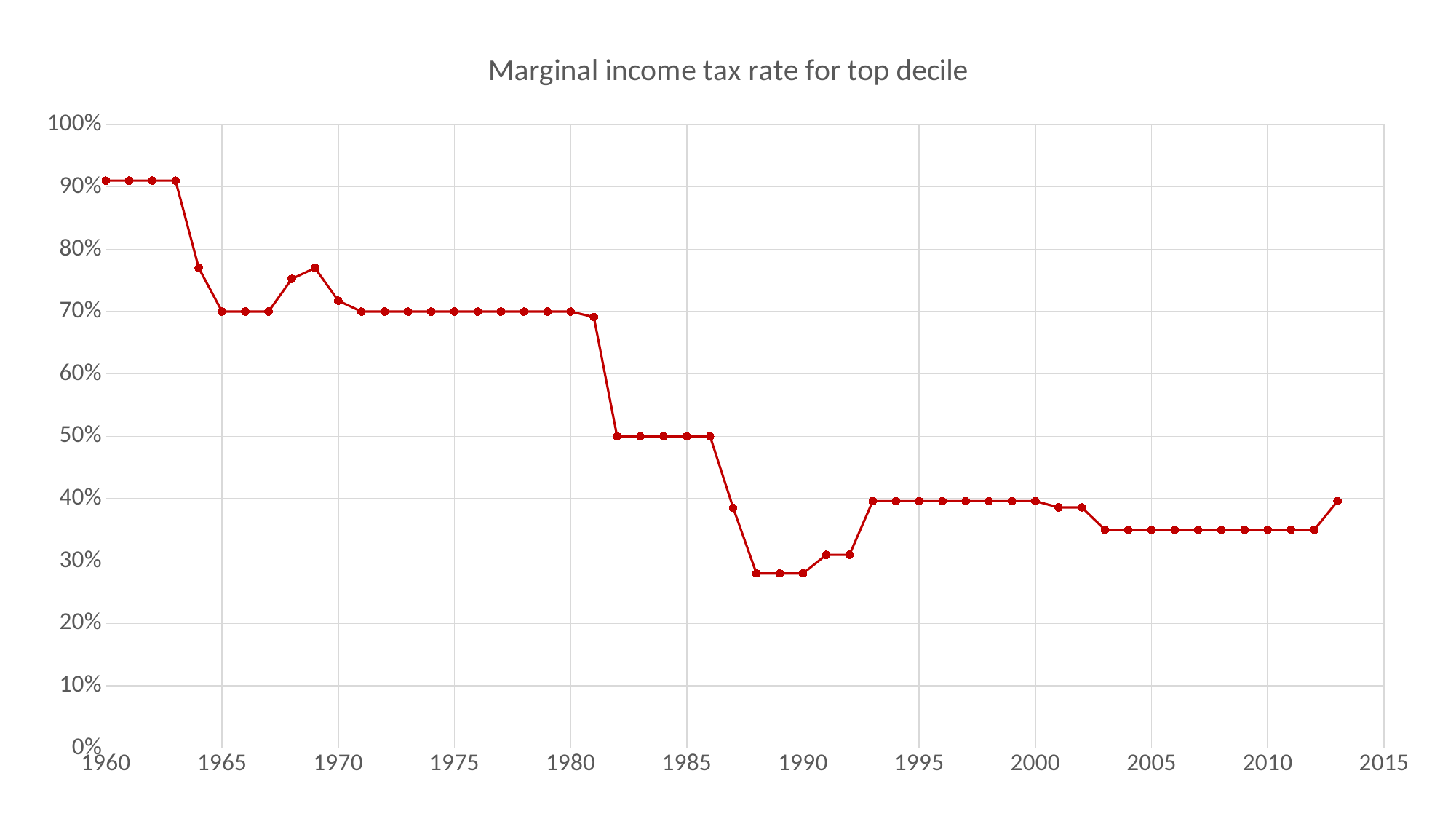
What is the marginal income tax rate for the top decile in 1975? 70% Is the value for 2005 greater or less than 40%? less Which year has the higher marginal tax rate, 1970 or 1990? 1970 Overall, does the marginal income tax rate rise or fall from 1960 to 2013? Fall What is the title of the chart? Marginal income tax rate for top decile Is the value for 1960 greater or less than 80%? greater Which year has the higher marginal tax rate, 1985 or 2000? 1985 What is the difference between the rate in 1975 and the rate in 1985? 20 percentage points What is the marginal income tax rate for the top decile in 1966? 70% What kind of chart is shown on the slide? Line chart What is the marginal income tax rate for the top decile in 1985? 50% Is the value for 1988 greater or less than 30%? less